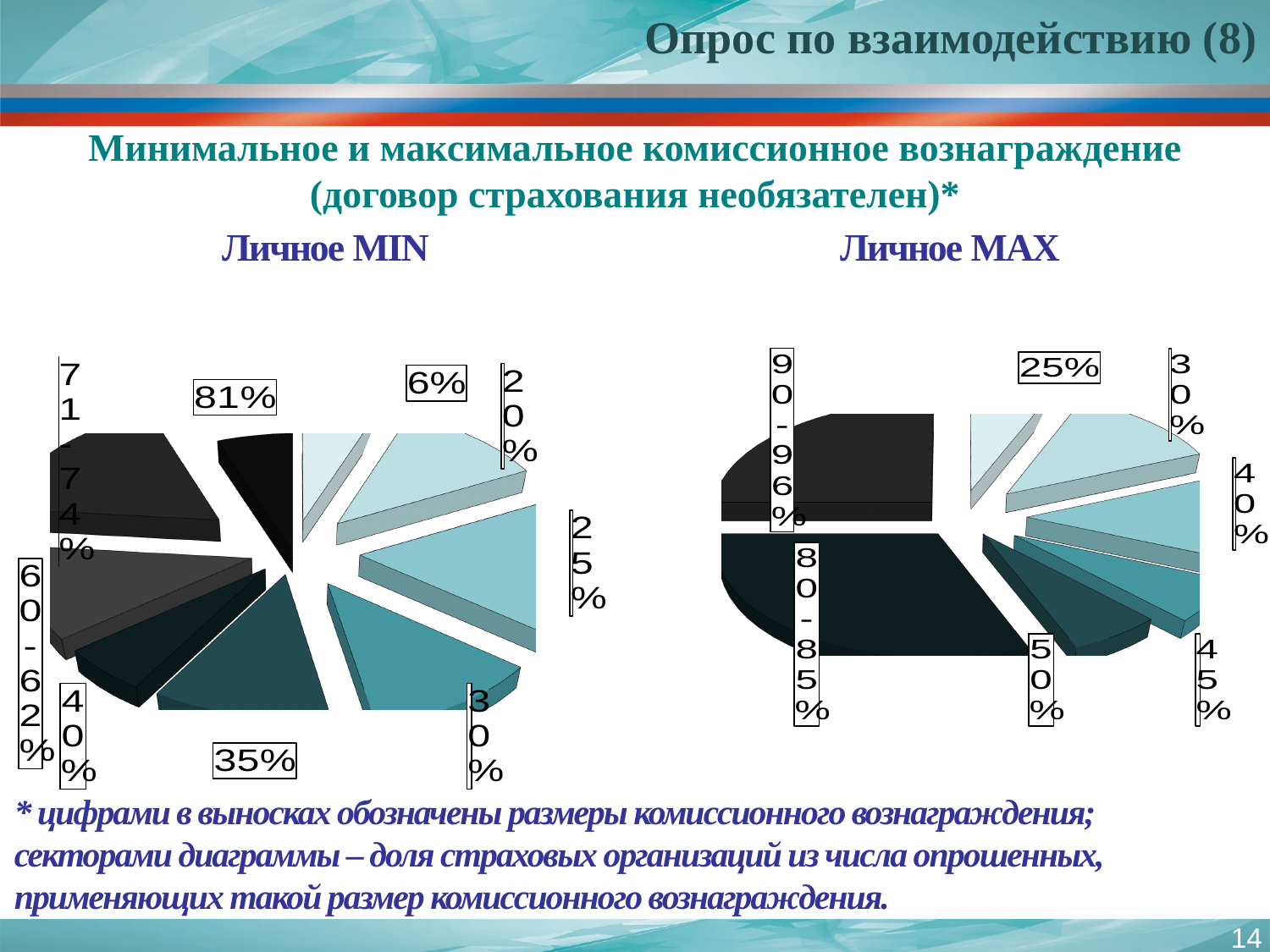
What is the title of the pie chart on the right side of the slide? Личное MAX What is the title of the pie chart on the left side of the slide? Личное MIN How many labelled slices does the "Личное MAX" pie chart have? 7 In the "Личное MIN" chart, what is the highest commission size shown as a slice label? 81% In the "Личное MAX" chart, which labelled slice is the largest? 80-85% How many labelled slices does the "Личное MIN" pie chart have? 9 In the "Личное MAX" chart, what is the highest commission size shown as a slice label? 90-96% Which chart has more labelled slices, "Личное MIN" or "Личное MAX"? Личное MIN In the "Личное MIN" chart, what is the lowest commission size shown as a slice label? 6% In the "Личное MAX" chart, what is the lowest commission size shown as a slice label? 25% What kind of chart is the "Личное MIN" chart? pie chart What kind of chart is the "Личное MAX" chart? pie chart